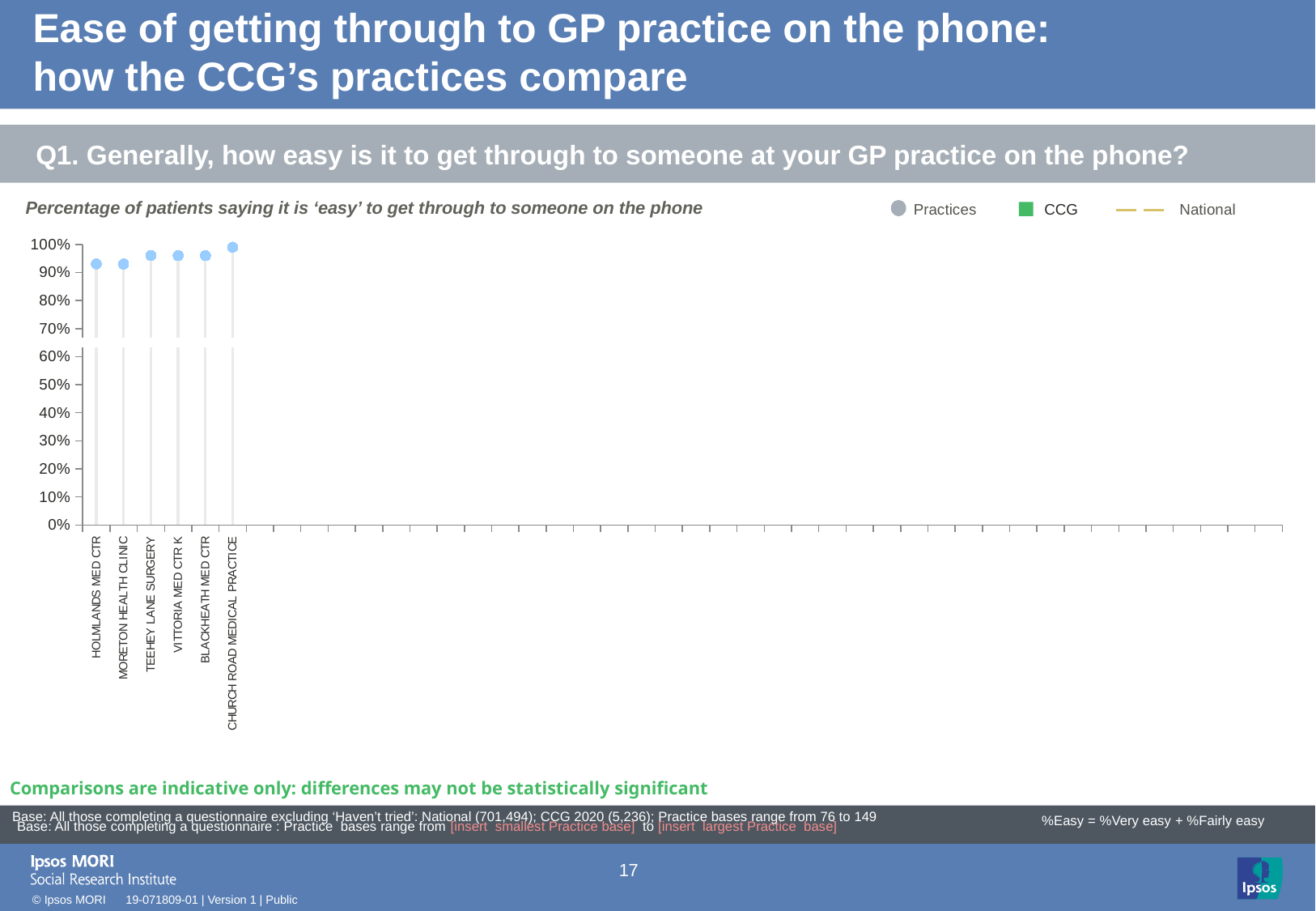
How many practices are plotted on the chart? 6 Which has the larger value, CHURCH ROAD MEDICAL PRACTICE or HOLMLANDS MED CTR? CHURCH ROAD MEDICAL PRACTICE Is the value for MORETON HEALTH CLINIC greater or less than 100%? less Is the value for TEEHEY LANE SURGERY greater or less than 90%? greater How many entries does the chart legend list? 3 Is the value for HOLMLANDS MED CTR greater or less than 80%? greater Which has the larger value, VITTORIA MED CTR K or MORETON HEALTH CLINIC? VITTORIA MED CTR K What is the first practice listed on the x axis? HOLMLANDS MED CTR What colour is the CCG marker in the legend? green Which practice has the highest percentage of patients saying it is 'easy' to get through on the phone? CHURCH ROAD MEDICAL PRACTICE Do the plotted values generally rise or fall from left to right across the practices? rise